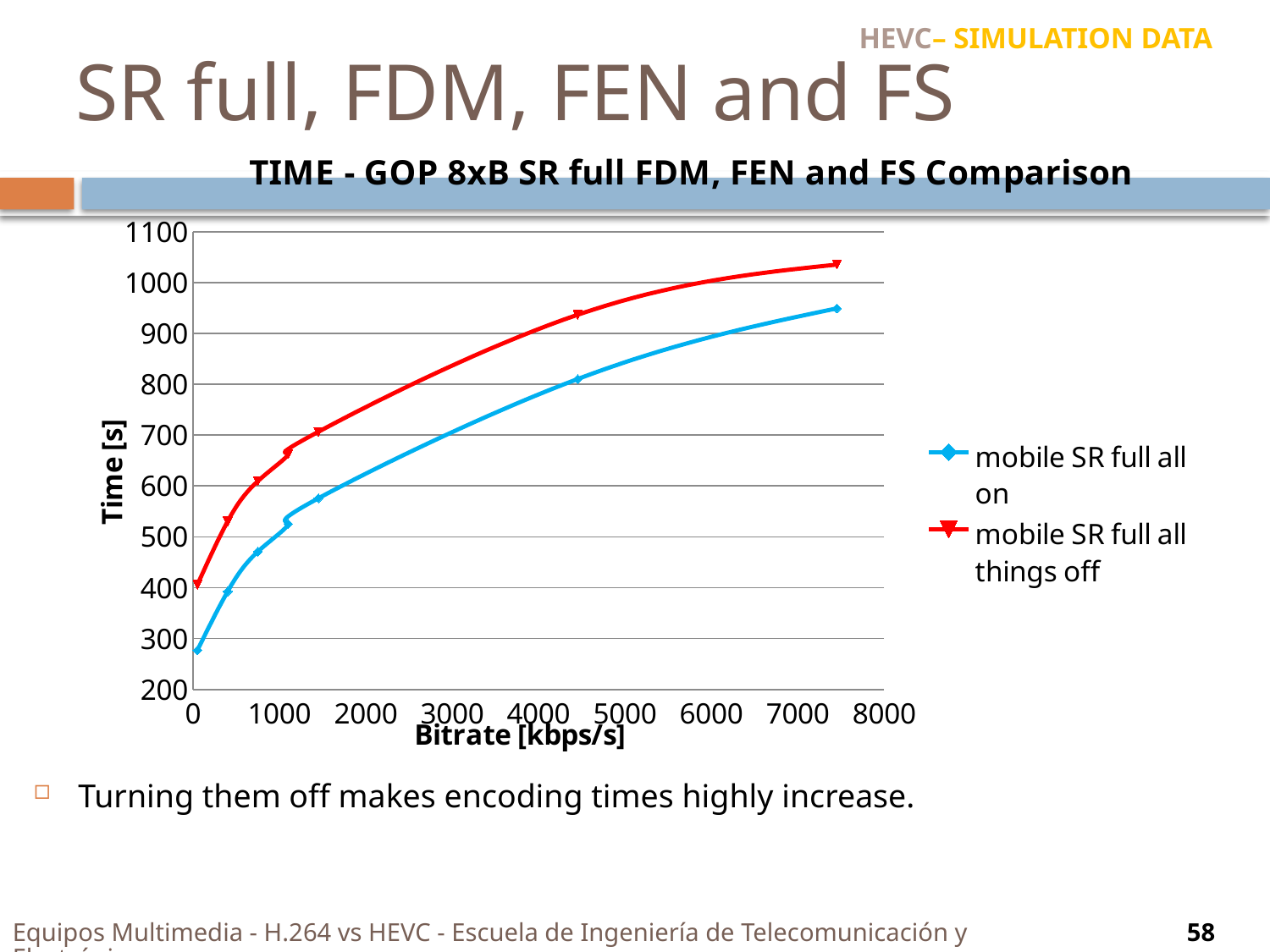
Which series has the higher encoding time across the bitrate range, 'mobile SR full all on' or 'mobile SR full all things off'? mobile SR full all things off Is the lowest value for 'mobile SR full all things off' greater or less than 300? greater Is the lowest value for 'mobile SR full all on' greater or less than 300? less How many series does the legend list? 2 What is the title of the chart? TIME - GOP 8xB SR full FDM, FEN and FS Comparison Does the encoding time for 'mobile SR full all on' rise or fall as bitrate increases? rise What kind of chart is shown on the slide? line chart Does the encoding time for 'mobile SR full all things off' rise or fall as bitrate increases? rise Is the highest value for 'mobile SR full all things off' greater or less than 1000? greater What is the label of the y axis? Time [s]